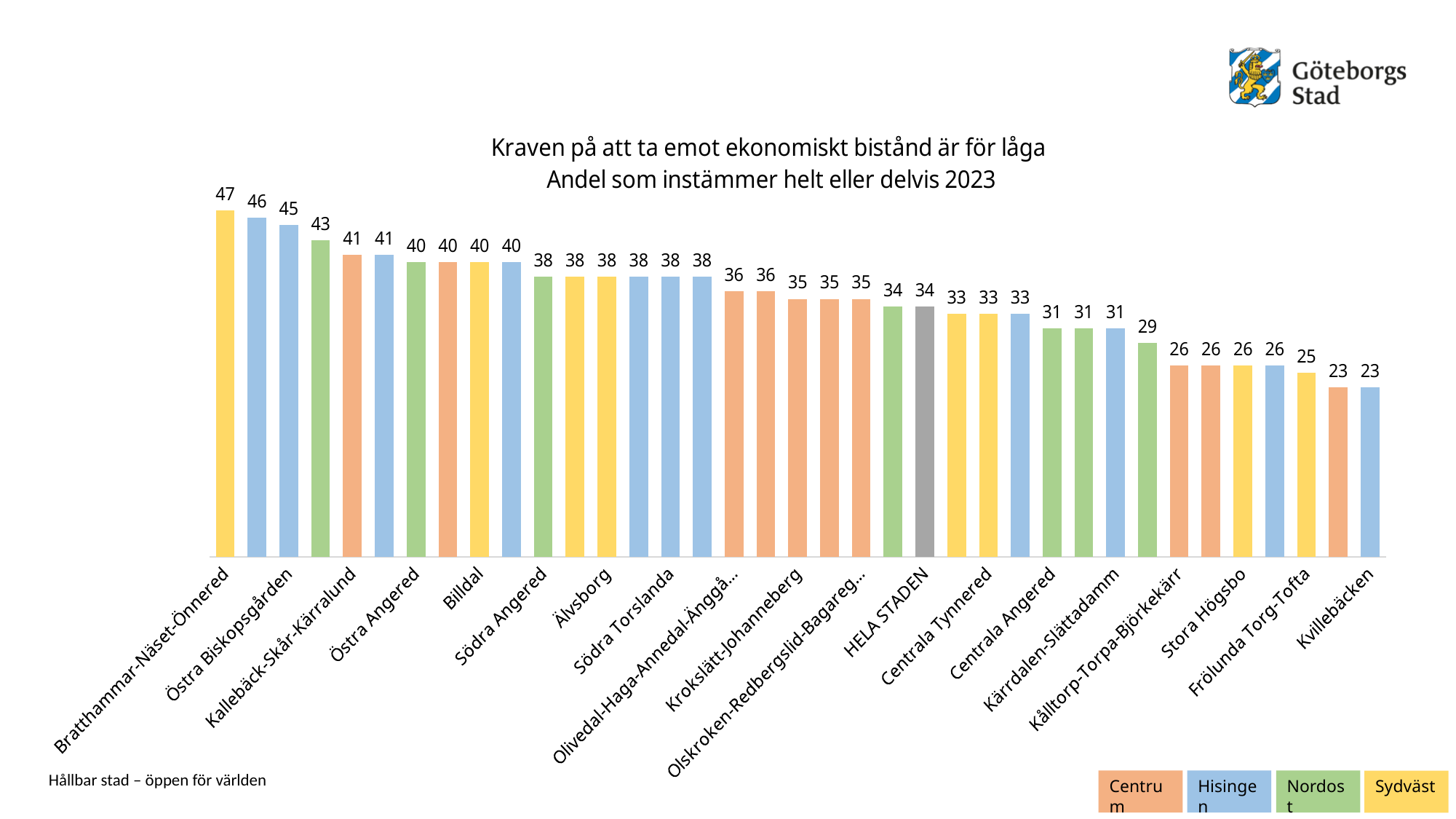
What value is shown for Frölunda Torg-Tofta? 25 Which labelled area has the highest value? Bratthammar-Näset-Önnered What value is shown for Billdal? 40 Do the values rise or fall from left to right along the x axis? Fall What value is shown for Kvillebäcken? 23 Which has a larger value, Östra Biskopsgården or Centrala Angered? Östra Biskopsgården How many entries does the legend list? 4 What kind of chart is shown on the slide? Bar chart What value is shown for HELA STADEN? 34 What is the lowest value shown on the chart? 23 What value is shown for Bratthammar-Näset-Önnered? 47 What is the difference between the values for Bratthammar-Näset-Önnered and Kvillebäcken? 24